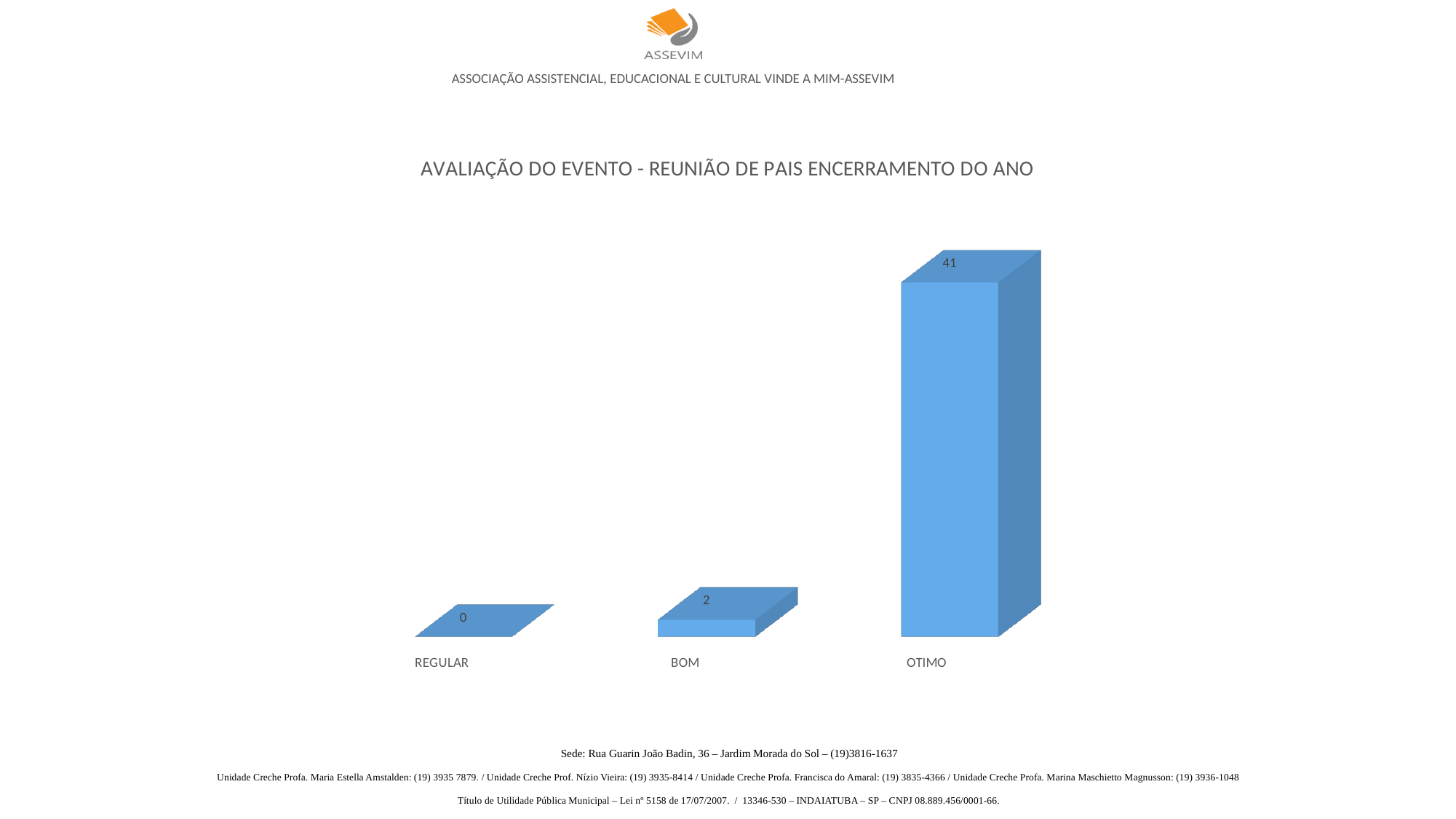
What is the title of the chart? AVALIAÇÃO DO EVENTO - REUNIÃO DE PAIS ENCERRAMENTO DO ANO Which category has the highest value? OTIMO What kind of chart is shown on the slide? bar chart What is the value for OTIMO? 41 Do the values rise or fall from REGULAR to OTIMO along the x axis? rise What is the value for REGULAR? 0 What is the total of the values for REGULAR, BOM and OTIMO? 43 What is the difference between the values for OTIMO and BOM? 39 How many categories are shown on the x axis? 3 Which is larger, the value for BOM or the value for REGULAR? BOM Which category has the lowest value? REGULAR What is the value for BOM? 2